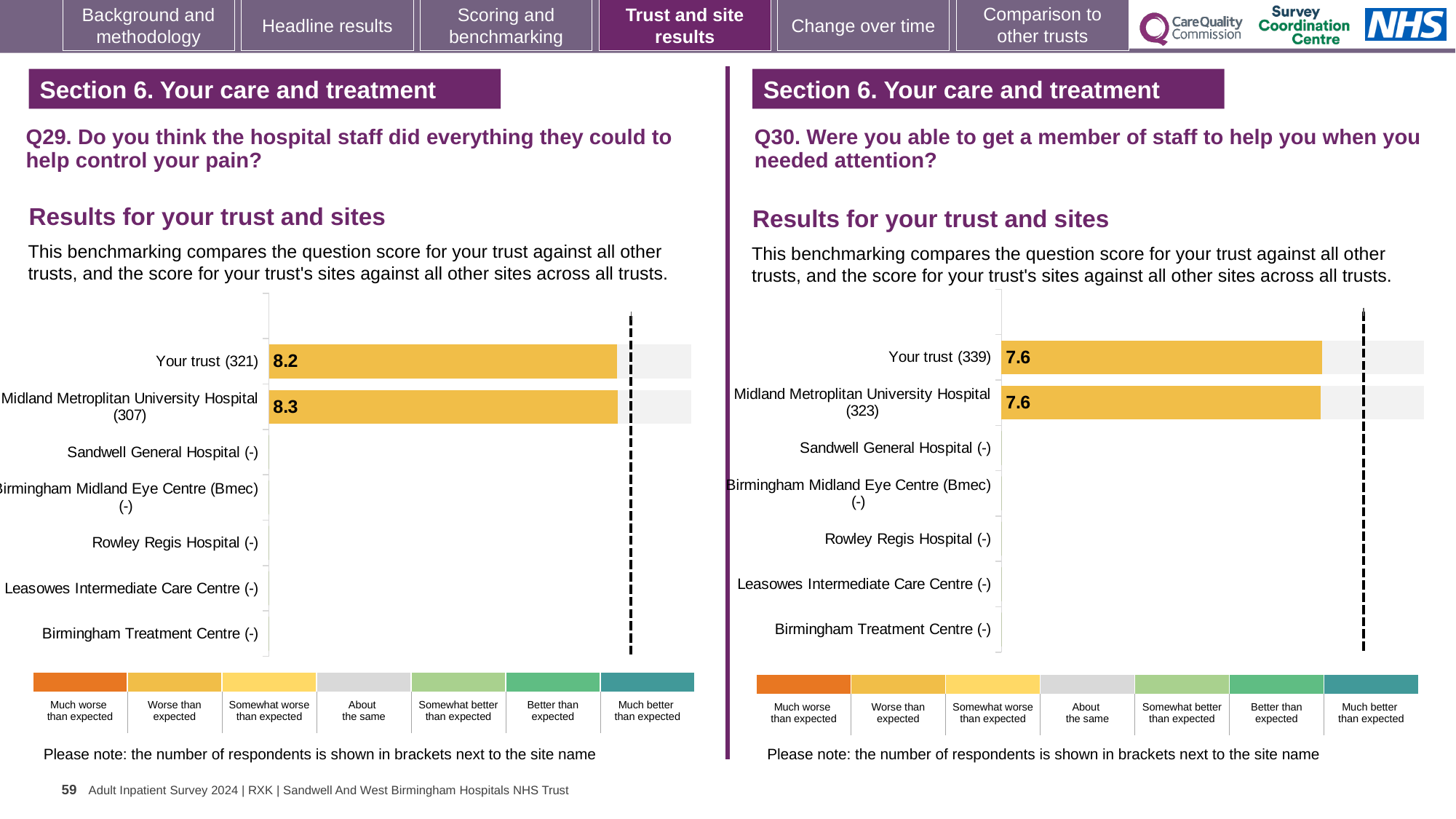
In the Q30 chart on the right, what is the difference between the Your trust score and the Midland Metropolitan University Hospital score? 0 In the Q29 chart on the left, what is the score for Midland Metropolitan University Hospital? 8.3 In the Q30 chart on the right, what is the score for Midland Metropolitan University Hospital? 7.6 In the Q29 chart on the left, what is the difference between the Midland Metropolitan University Hospital score and the Your trust score? 0.1 In the Q29 chart on the left, how many respondents are shown in brackets for Your trust? 321 In the Q30 chart on the right, how many respondents are shown in brackets for Midland Metropolitan University Hospital? 323 What kind of chart is the Q29 chart on the left? Bar chart In the Q30 chart on the right, is the score for Your trust greater than, less than, or equal to the score for Midland Metropolitan University Hospital? Equal In the Q30 chart on the right, what is the score for Your trust? 7.6 How many site categories are listed on the vertical axis of the Q30 chart on the right? 7 In the Q29 chart on the left, what is the score for Your trust? 8.2 In the Q29 chart on the left, how many categories have a plotted bar? 2